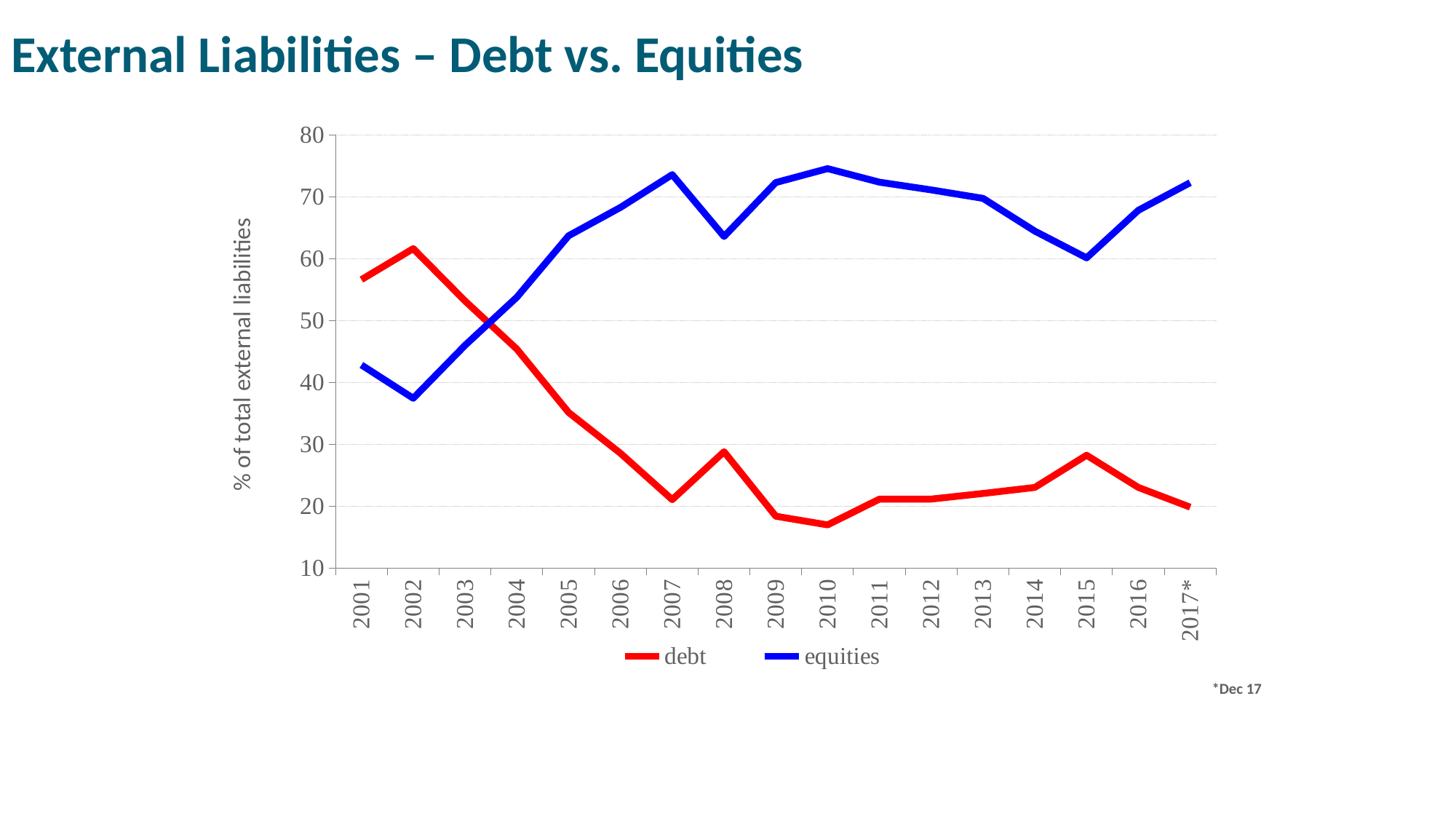
Overall, does the debt series rise or fall from 2001 to 2017*? fall Is the value for debt in 2010 greater or less than 20? less How many years are plotted along the x axis? 17 In 2001, which series has the larger value, debt or equities? debt In which year does the equities series reach its lowest value? 2002 Is the value for equities in 2007 greater or less than 70? greater Is the value for debt in 2001 greater or less than 50? greater In which year does the debt series reach its highest value? 2002 In 2005, which series has the larger value, debt or equities? equities What kind of chart is shown on the slide? line chart How many series does the legend list? 2